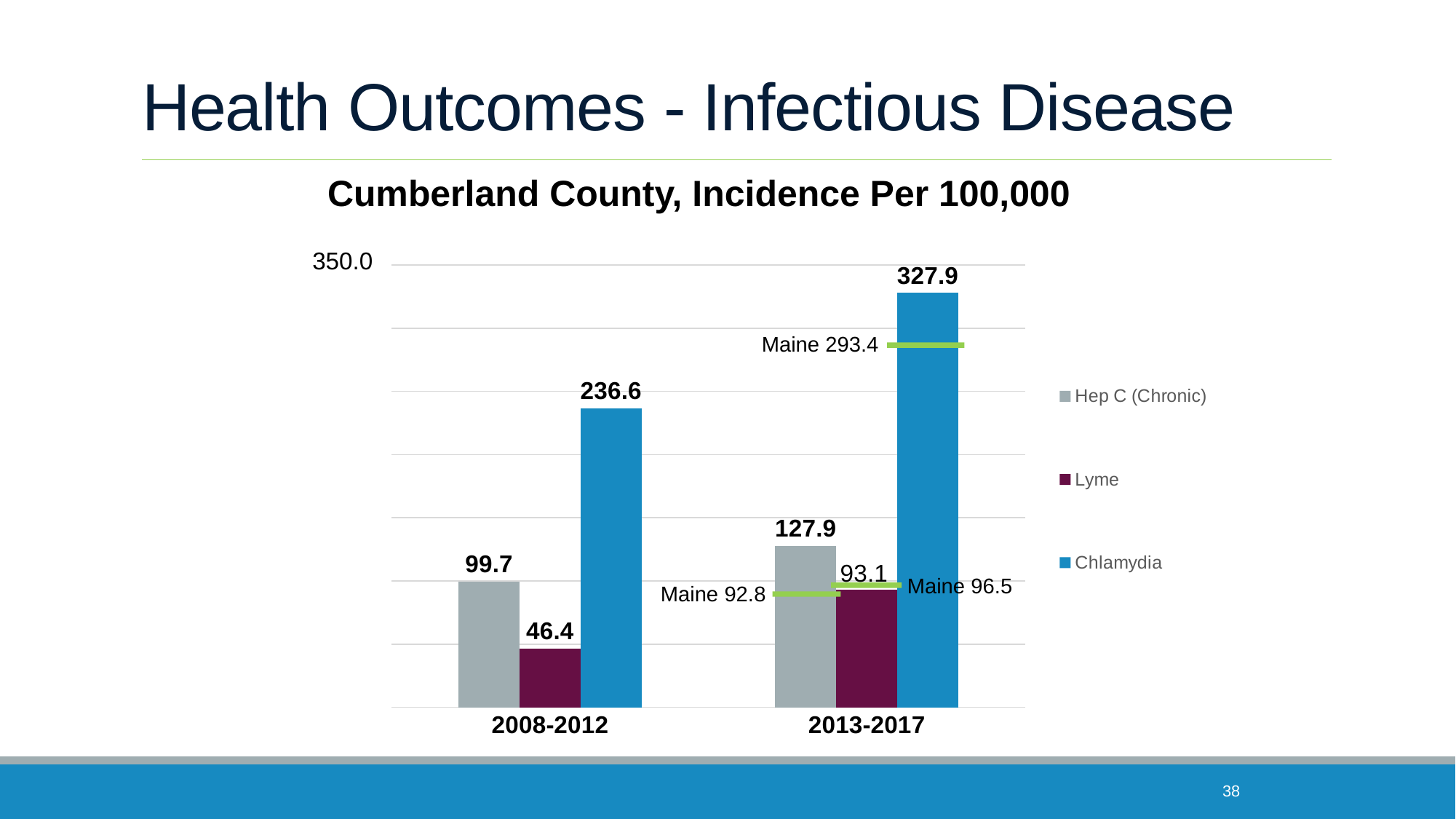
What is the difference between the Hep C (Chronic) values for 2013-2017 and 2008-2012? 28.2 What is the Lyme incidence per 100,000 in Cumberland County for 2013-2017? 93.1 Does the Lyme incidence rise or fall from 2008-2012 to 2013-2017? Rise What is the Hep C (Chronic) incidence per 100,000 in Cumberland County for 2008-2012? 99.7 Which series has the lowest value in the 2008-2012 period? Lyme Which series has the highest value in the 2008-2012 period? Chlamydia Which is larger, the Lyme value for 2013-2017 or the Hep C (Chronic) value for 2008-2012? Hep C (Chronic) value for 2008-2012 What kind of chart is shown on the slide? Bar chart What is the Maine value shown for Chlamydia in 2013-2017? 293.4 By how much did the Chlamydia incidence increase from 2008-2012 to 2013-2017? 91.3 What is the Chlamydia incidence per 100,000 in Cumberland County for 2013-2017? 327.9 How many series does the legend list? 3